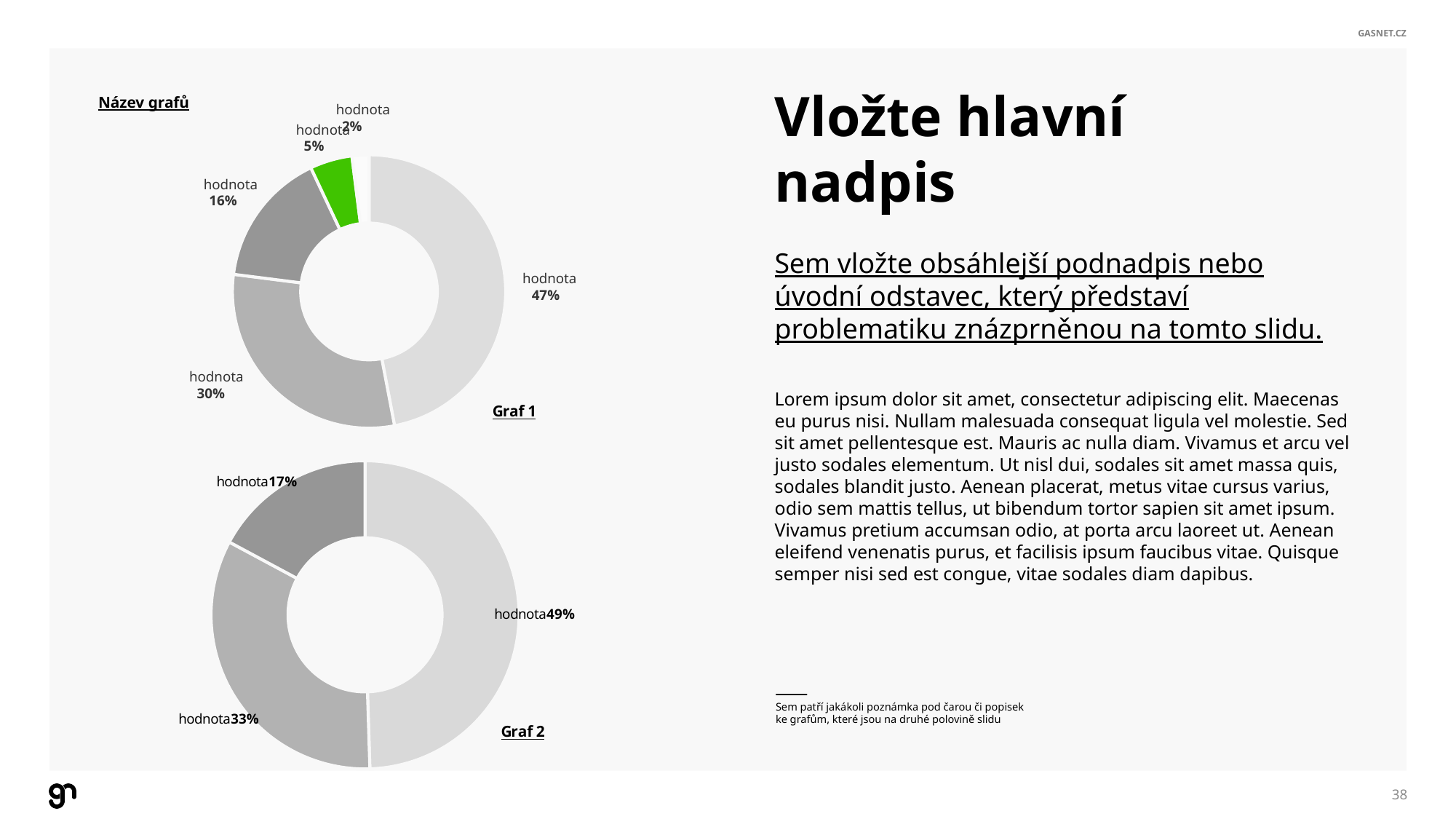
What is the title shown above the charts on the slide? Název grafů In Graf 2, what is the share of the largest slice? 49% How many slices does Graf 1 have? 5 What kind of chart is Graf 2? Doughnut chart In Graf 1, what is the share of the smallest slice? 2% In Graf 2, what is the share of the smallest slice? 17% In Graf 1, what is the share of the largest slice? 47% In Graf 1, what is the share of the green slice? 5% In Graf 2, what is the difference between the 49% slice and the 33% slice? 16 percentage points How many slices does Graf 2 have? 3 What kind of chart is Graf 1? Doughnut chart In Graf 1, what is the difference between the largest slice (47%) and the second largest slice (30%)? 17 percentage points